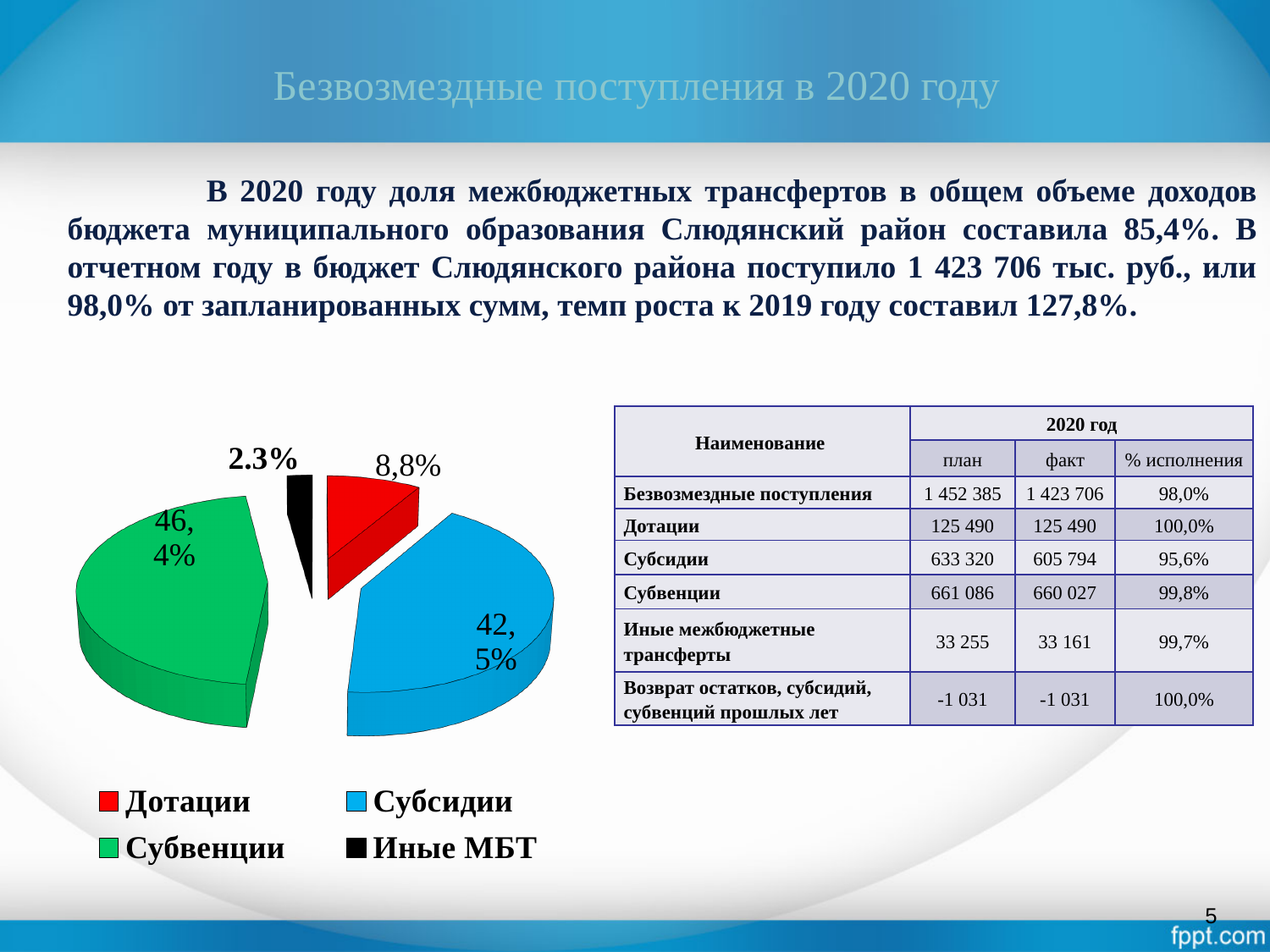
Which category has the largest slice in the pie chart? Субвенции What share of the pie chart does Субвенции account for? 46,4% By how many percentage points does the Субвенции slice exceed the Субсидии slice? 3,9 What share of the pie chart does Иные МБТ account for? 2.3% What colour is the Субсидии slice in the pie chart? blue Which slice is larger in the pie chart, Дотации or Субсидии? Субсидии What type of chart is shown on the slide? pie chart How many slices does the pie chart have? 4 Which category has the smallest slice in the pie chart? Иные МБТ By how many percentage points does the Субвенции slice exceed the Дотации slice? 37,6 What share of the pie chart does Субсидии account for? 42,5% What share of the pie chart does Дотации account for? 8,8%